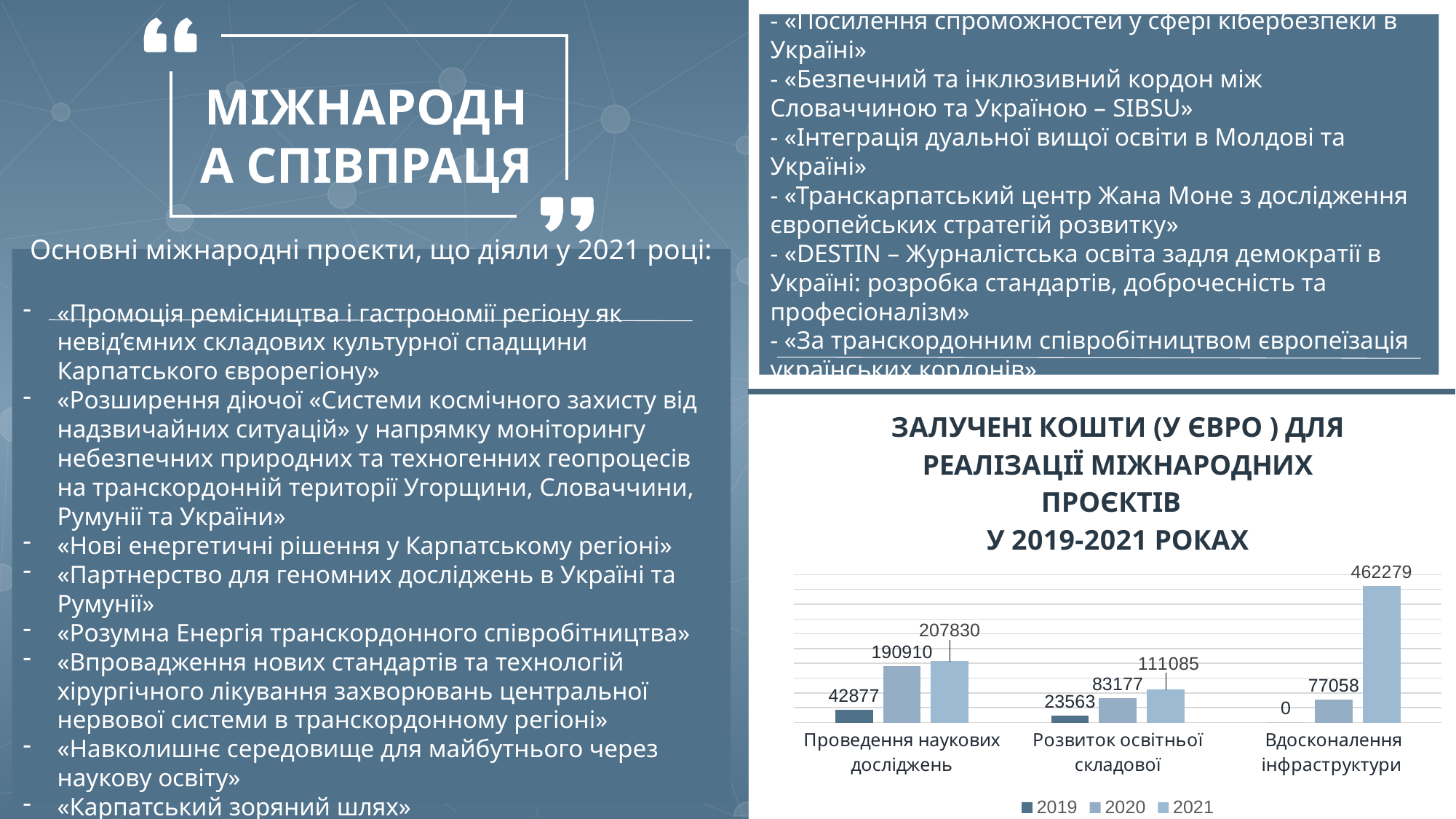
How many series does the chart legend list? 3 Which category has the lowest value for 2020? Вдосконалення інфраструктури Which is larger: the 2021 value for «Розвиток освітньої складової» or the 2020 value for «Проведення наукових досліджень»? 2020 value for «Проведення наукових досліджень» Which category has the highest value for 2021? Вдосконалення інфраструктури What is the value for 2020 in the category «Вдосконалення інфраструктури»? 77058 What is the value for 2021 in the category «Проведення наукових досліджень»? 207830 What is the difference between the 2021 and 2020 values for «Проведення наукових досліджень»? 16920 How many categories are shown on the x axis of the chart? 3 Which years are listed in the chart legend? 2019, 2020, 2021 What is the value for 2019 in the category «Розвиток освітньої складової»? 23563 What type of chart is shown on the slide? bar chart What is the value for 2019 in the category «Вдосконалення інфраструктури»? 0